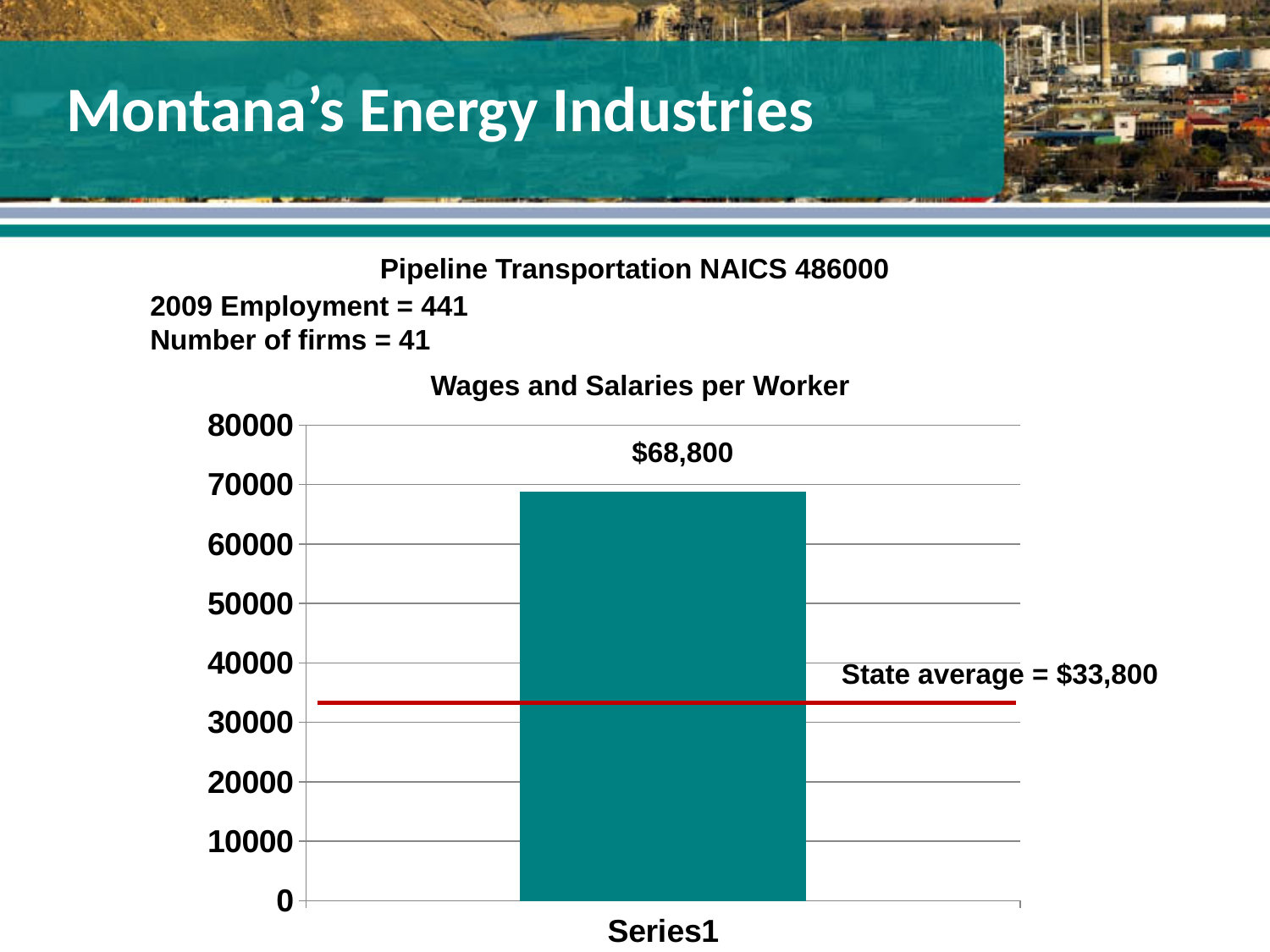
What is the state average shown by the red line in the chart? $33,800 Is the value of the bar greater or less than 60000? greater What is the category label on the x axis of the chart? Series1 What is the maximum value shown on the y axis of the chart? 80000 What is the value of the bar in the Wages and Salaries per Worker chart? $68,800 What is the title of the chart? Wages and Salaries per Worker Which is larger, the bar value or the state average? the bar value ($68,800) What kind of chart is shown on the slide? bar chart Is the state average line greater or less than 40000? less How many bars are plotted in the chart? 1 What is the difference between the bar value and the state average? $35,000